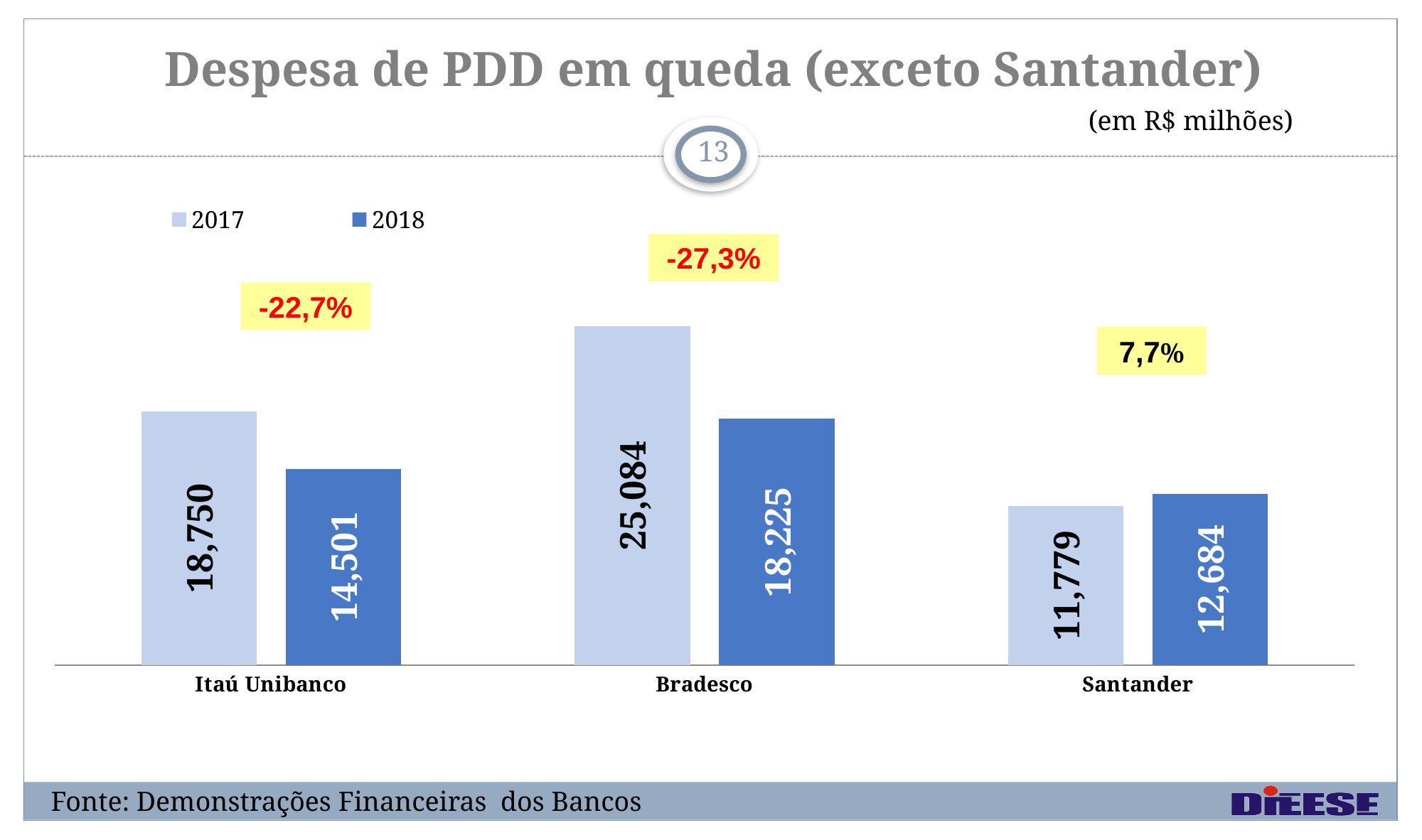
What was the PDD expense for Santander in 2018? 12,684 What is the difference between Bradesco's 2017 and 2018 PDD expense? 6,859 Which bank had the highest PDD expense in 2017? Bradesco How many banks are shown on the x axis of the chart? 3 What kind of chart is shown on the slide? Bar chart What was the PDD expense for Bradesco in 2017? 25,084 How many series does the legend list? 2 What is the difference between Itaú Unibanco's 2017 and 2018 PDD expense? 4,249 What was the PDD expense for Itaú Unibanco in 2018? 14,501 Which bank had the lowest PDD expense in 2018? Santander For Santander, which year had the larger PDD expense, 2017 or 2018? 2018 What percentage change is shown above the Bradesco bars? -27,3%